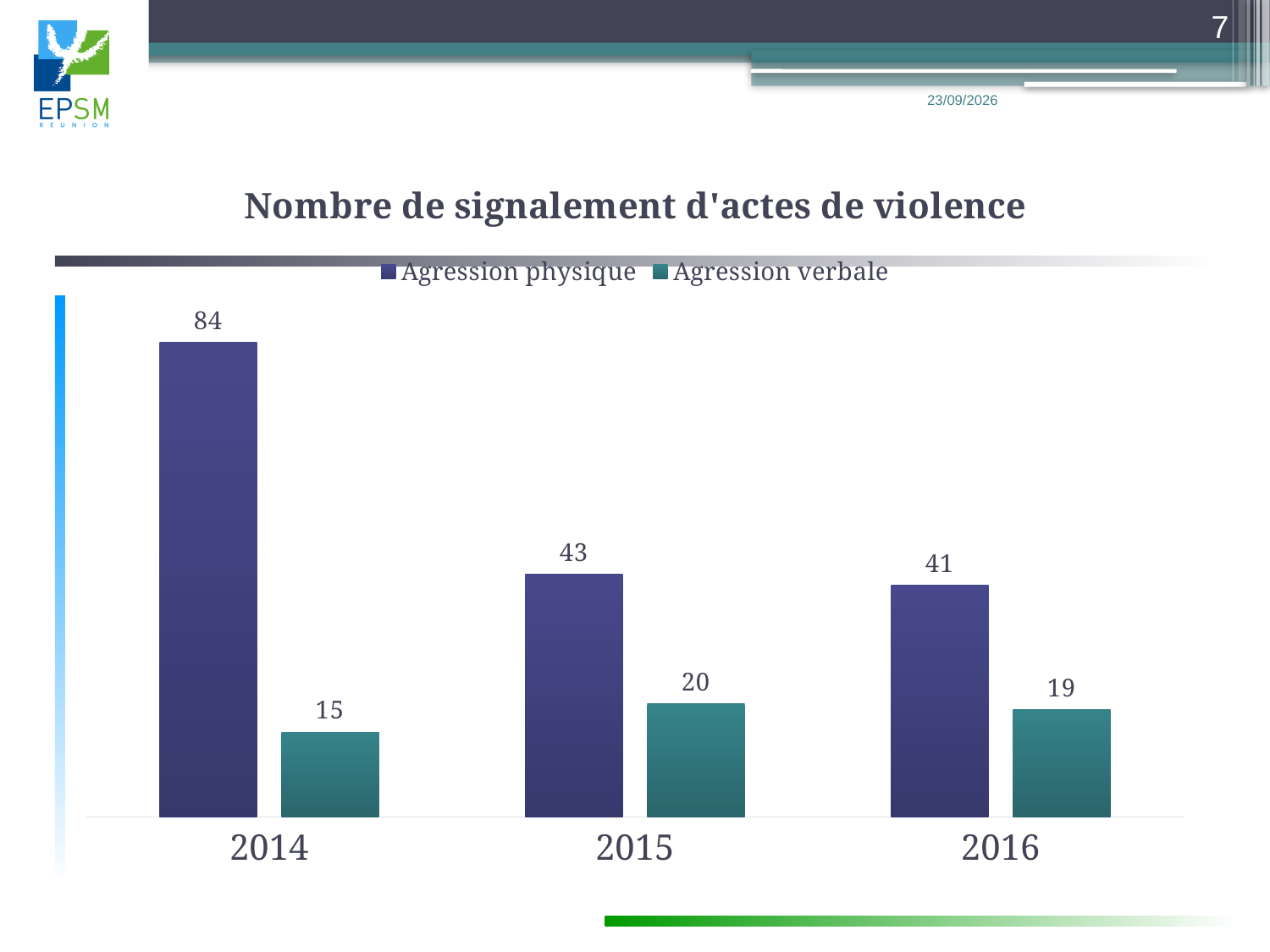
What is the difference between Agression physique and Agression verbale in 2014? 69 Which year has the highest value for Agression physique? 2014 What is the value for Agression verbale in 2015? 20 Which year has the lowest value for Agression verbale? 2014 How many years are shown on the x axis? 3 What kind of chart is shown on the slide? Bar chart What is the title of the chart? Nombre de signalement d'actes de violence How many series does the legend list? 2 Which is larger in 2016, Agression physique or Agression verbale? Agression physique What is the value for Agression physique in 2014? 84 What is the value for Agression physique in 2016? 41 What is the difference between Agression physique in 2014 and in 2015? 41